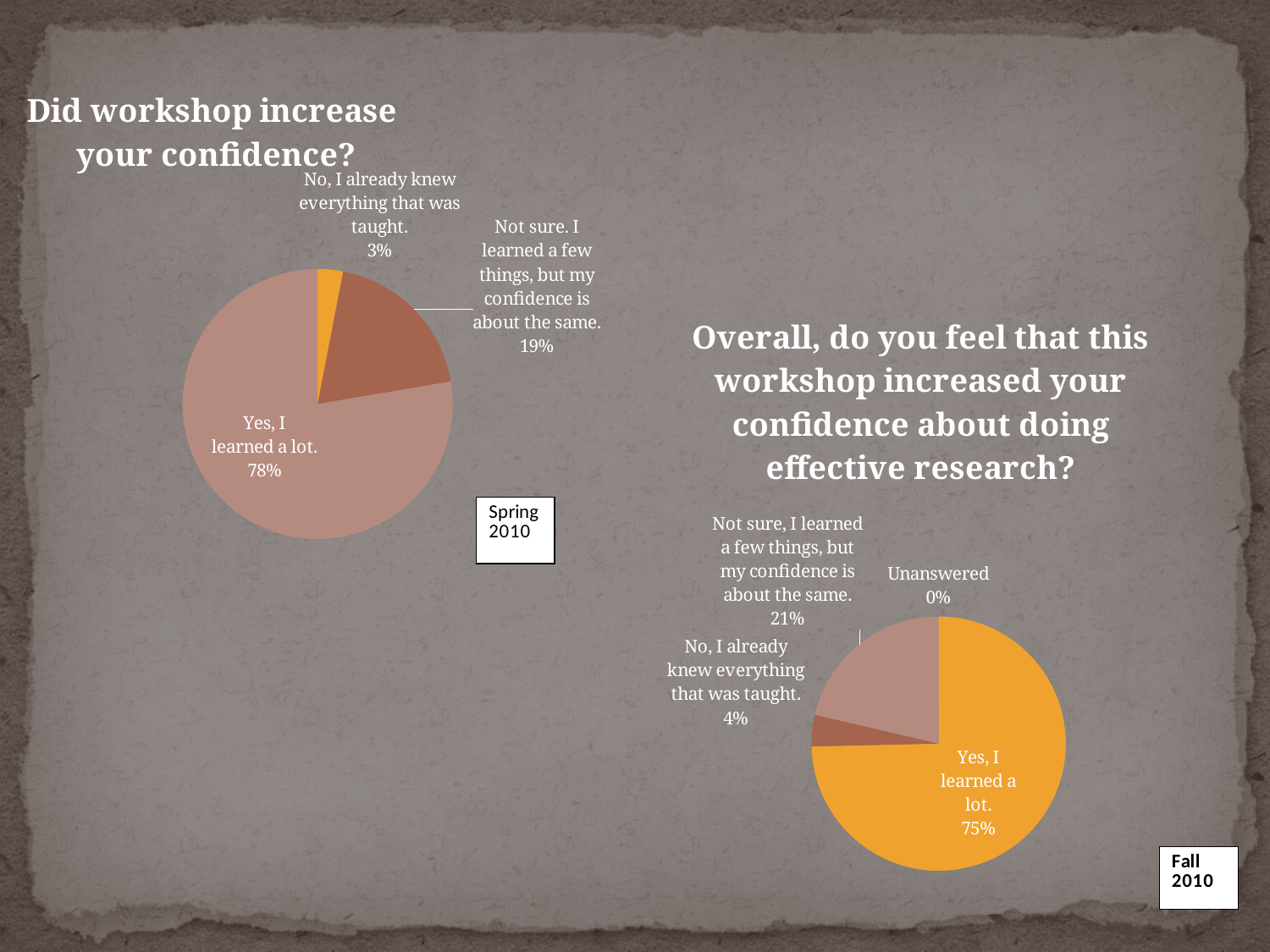
In the Spring 2010 pie chart on the left, which response has the smallest share? No, I already knew everything that was taught. In the Fall 2010 pie chart on the right, what share answered "No, I already knew everything that was taught."? 4% In the Fall 2010 pie chart on the right, what share of respondents answered "Yes, I learned a lot."? 75% In the Fall 2010 pie chart on the right, which response has the largest share? Yes, I learned a lot. In the Spring 2010 pie chart on the left, what share answered "Not sure. I learned a few things, but my confidence is about the same."? 19% In the Spring 2010 pie chart on the left, what share of respondents answered "Yes, I learned a lot."? 78% In the Spring 2010 pie chart on the left, what share answered "No, I already knew everything that was taught."? 3% How many slices are labelled in the Fall 2010 pie chart on the right? 4 What type of chart is used on this slide? Pie chart What is the difference between the "Yes, I learned a lot." share in the Spring 2010 chart and the same response in the Fall 2010 chart? 3 percentage points In the Fall 2010 pie chart on the right, what share is labelled "Unanswered"? 0% Which chart shows a larger share for "Not sure, I learned a few things, but my confidence is about the same": Spring 2010 or Fall 2010? Fall 2010